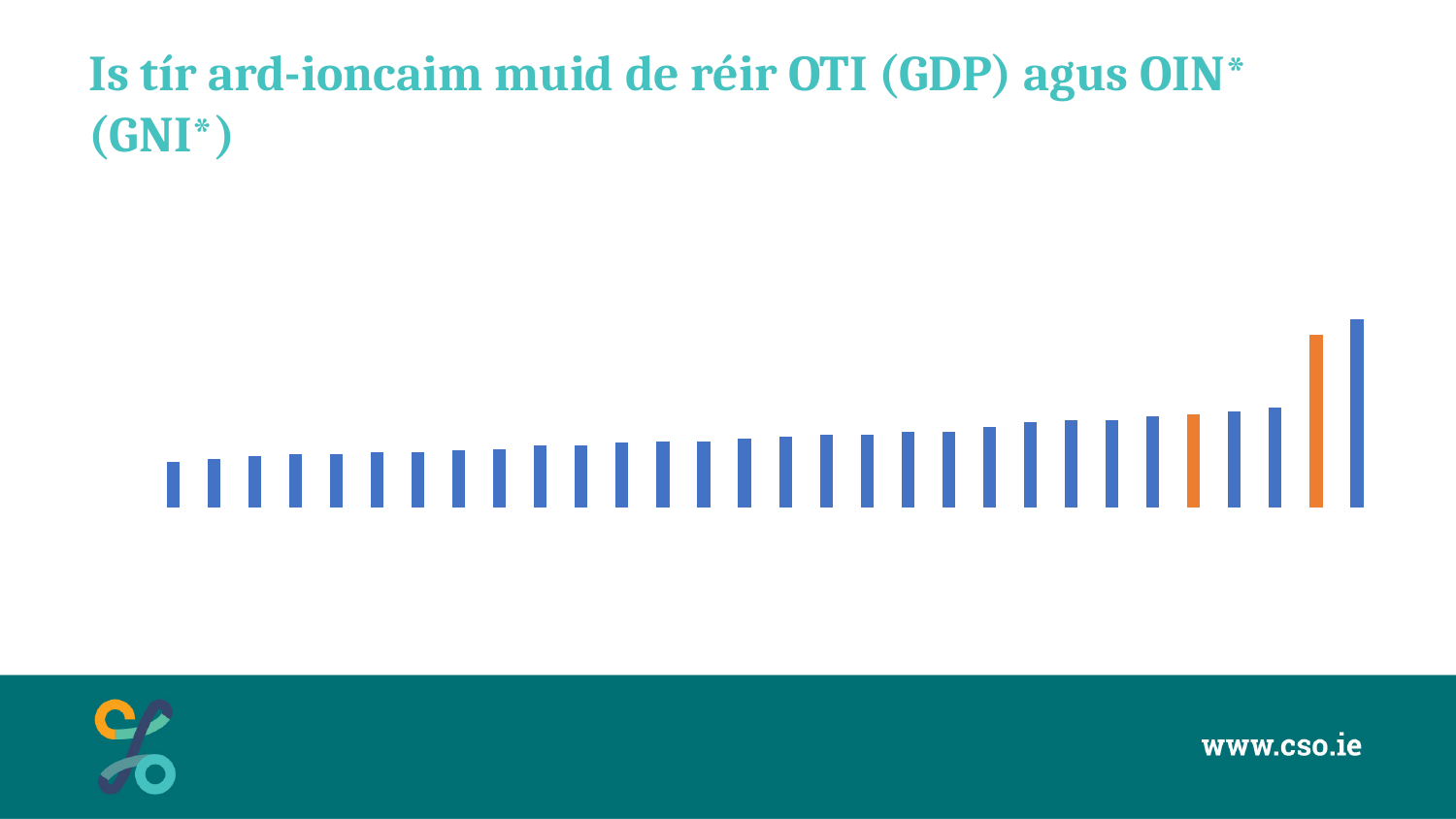
What colour are most of the bars in the chart? blue Is the rightmost bar taller or shorter than the second-rightmost (orange) bar? taller How many bars are highlighted in orange in the chart? 2 Which bar is the shortest in the chart? the leftmost bar What is the title of the slide containing the chart? Is tír ard-ioncaim muid de réir OTI (GDP) agus OIN* (GNI*) Is the orange bar on the right taller or shorter than the orange bar further left? taller What kind of chart is shown on the slide? bar chart Which bar is the tallest in the chart? the rightmost bar Do the bar heights generally rise or fall from left to right across the chart? rise